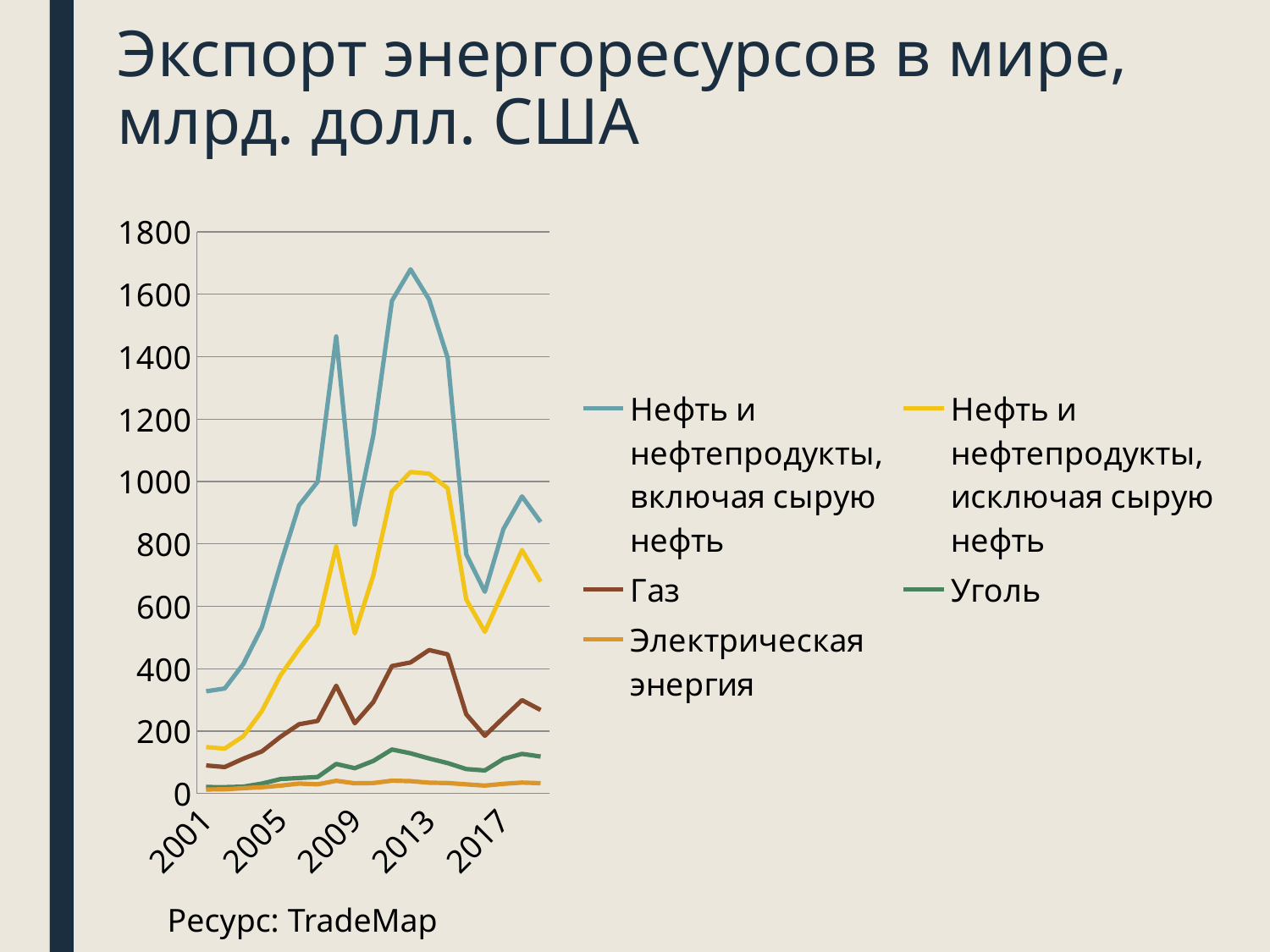
Which series reaches the highest value on the chart? Нефть и нефтепродукты, включая сырую нефть Is the value for 'Газ' in 2001 greater or less than 200? less What is the title of the chart on the slide? Экспорт энергоресурсов в мире, млрд. долл. США Does the series 'Нефть и нефтепродукты, включая сырую нефть' rise or fall between 2001 and 2005? rise What source is cited below the chart? TradeMap What kind of chart is shown on the slide? line chart Which series has the lowest values throughout the chart? Электрическая энергия Is the value for 'Уголь' in 2013 greater or less than 200? less How many series does the legend list? 5 In 2013, which is larger: the value for 'Газ' or the value for 'Уголь'? Газ